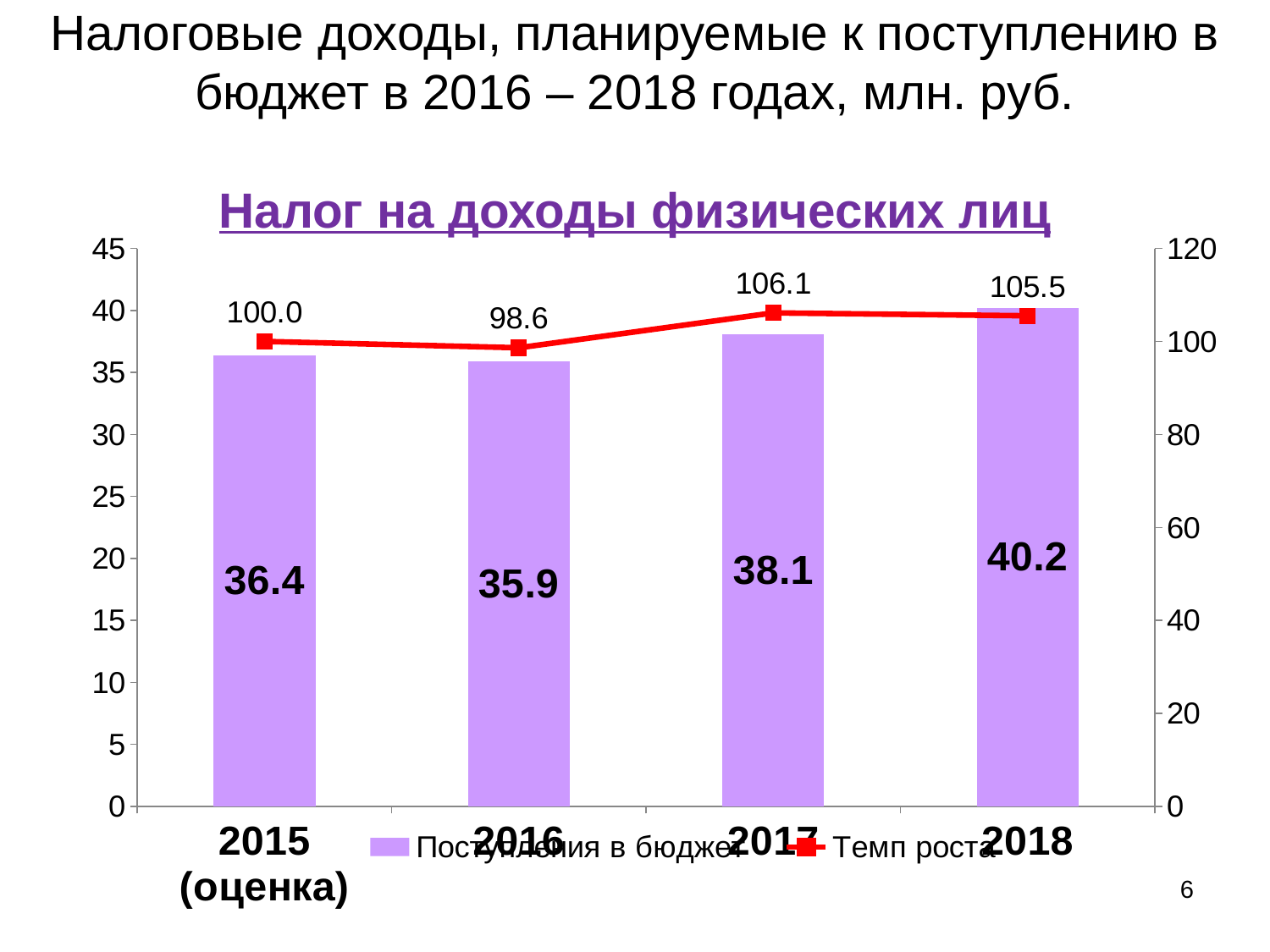
Which is larger, Поступления в бюджет in 2017 or in 2016? 2017 What is the Темп роста value for 2017? 106.1 How many years are shown on the x axis? 4 What is the value of Поступления в бюджет for 2016? 35.9 What is the difference between Поступления в бюджет in 2018 and in 2015 (оценка)? 3.8 How many series does the legend list? 2 What kind of chart is shown on the slide? Combined bar and line chart Do the Поступления в бюджет values rise or fall from 2016 to 2018? Rise What is the Темп роста value for 2015 (оценка)? 100.0 What is the value of Поступления в бюджет for 2018? 40.2 Which year has the lowest Темп роста value? 2016 Which year has the highest value of Поступления в бюджет? 2018